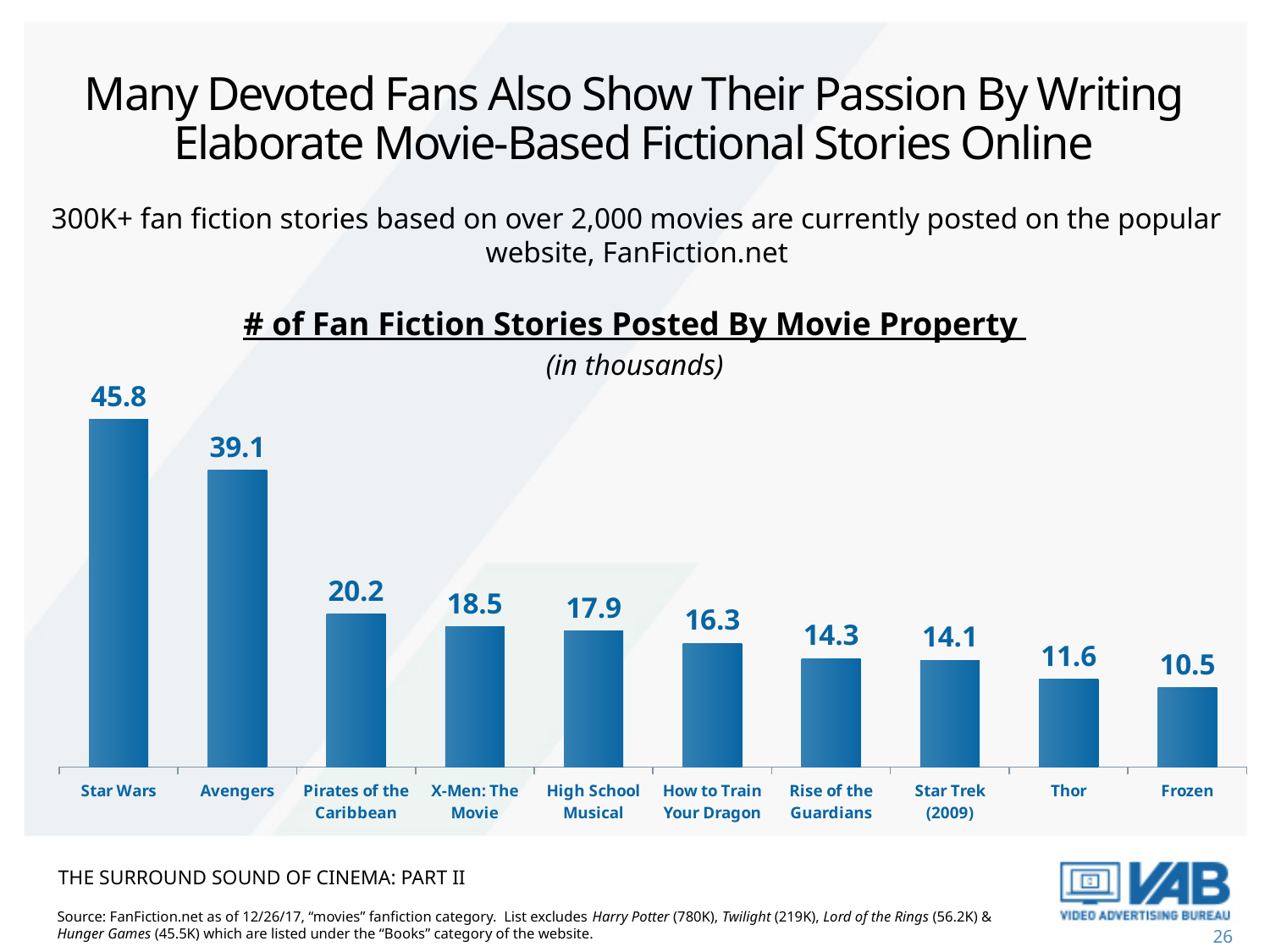
What is the value for Pirates of the Caribbean? 20.2 Which movie property has the lowest number of fan fiction stories? Frozen What is the value for Star Trek (2009)? 14.1 What is the difference between the values for Thor and Frozen? 1.1 Which movie property has the highest number of fan fiction stories? Star Wars What is the title of the chart? # of Fan Fiction Stories Posted By Movie Property What is the difference between the values for Star Wars and Avengers? 6.7 Do the values rise or fall from left to right across the chart? Fall What kind of chart is shown on the slide? Bar chart What is the value for Star Wars? 45.8 Which has a larger value, X-Men: The Movie or How to Train Your Dragon? X-Men: The Movie How many movie properties are shown in the chart? 10